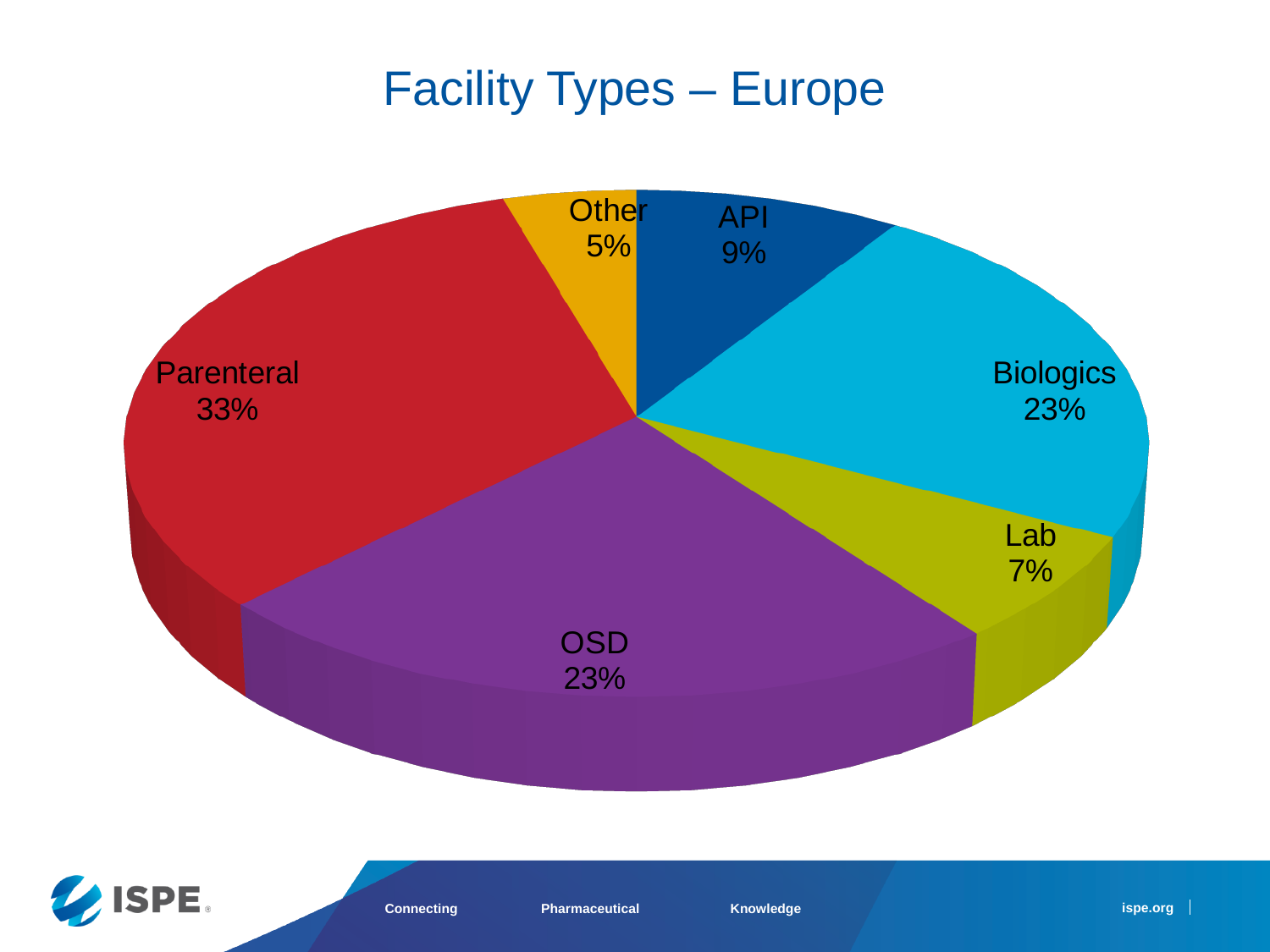
What percentage is shown for API? 9% What is the title of the chart? Facility Types – Europe Which facility type has the smallest share of the pie? Other Which is larger, the share for API or the share for Lab? API What is the difference in percentage points between Parenteral and OSD? 10 How many slices does the pie chart have? 6 What share of the pie does Parenteral represent? 33% What is the difference in percentage points between API and Other? 4 What kind of chart is shown on the slide? Pie chart What percentage is shown for Biologics? 23% What percentage is shown for Lab? 7% Which facility type has the largest share of the pie? Parenteral